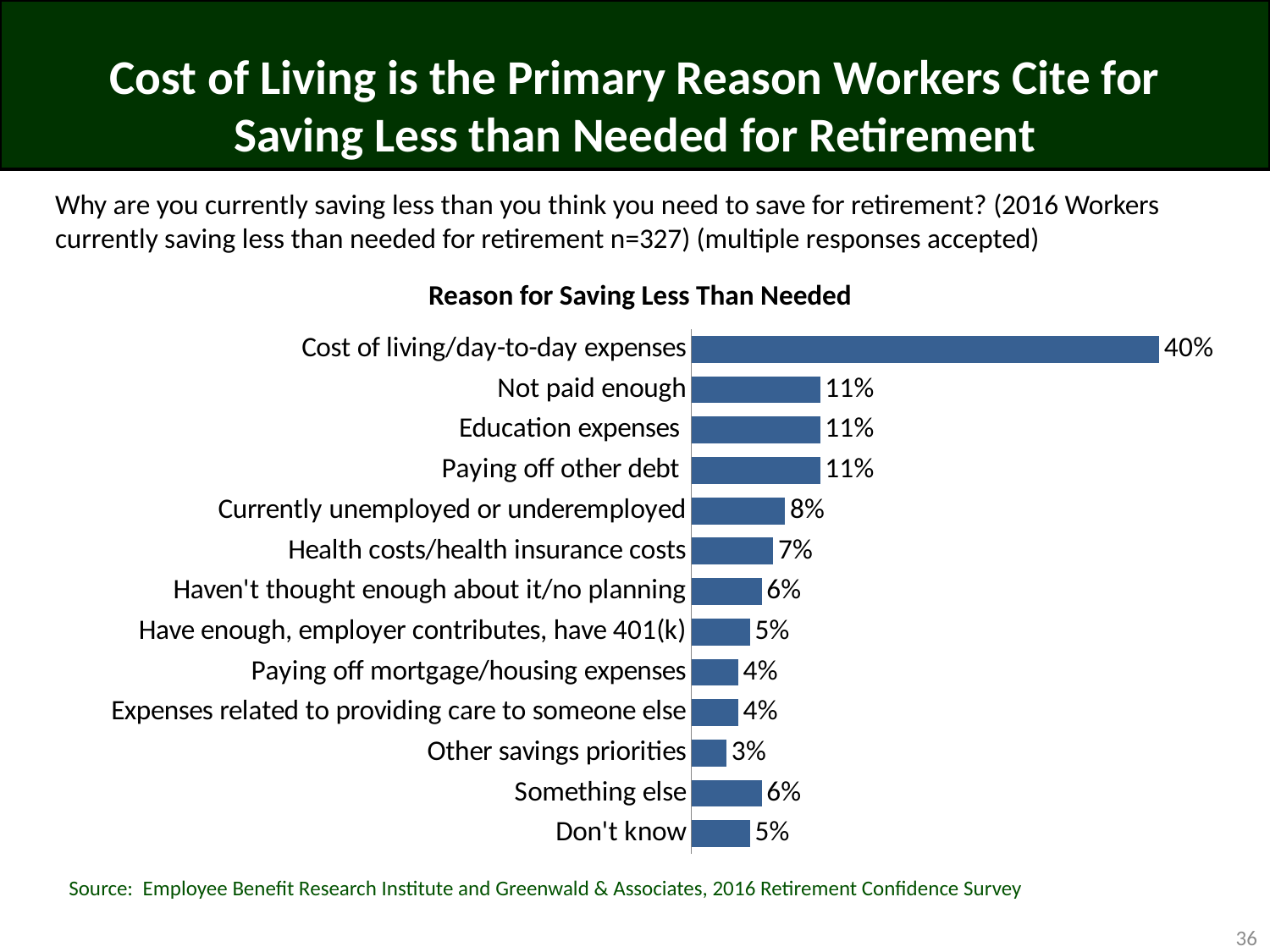
Which reason has the lowest value in the chart? Other savings priorities What is the value for Health costs/health insurance costs? 7% What is the value for Currently unemployed or underemployed? 8% What is the title of the chart? Reason for Saving Less Than Needed What type of chart is shown on the slide? Bar chart What is the difference between the value for Cost of living/day-to-day expenses and the value for Not paid enough? 29% What is the value for Other savings priorities? 3% Which reason has the highest value in the chart? Cost of living/day-to-day expenses What percentage of workers cited cost of living/day-to-day expenses as a reason for saving less than needed? 40% Which is larger: the value for Haven't thought enough about it/no planning or the value for Don't know? Haven't thought enough about it/no planning What is the difference between the value for Currently unemployed or underemployed and the value for Paying off mortgage/housing expenses? 4% How many reasons (categories) are shown in the chart? 13